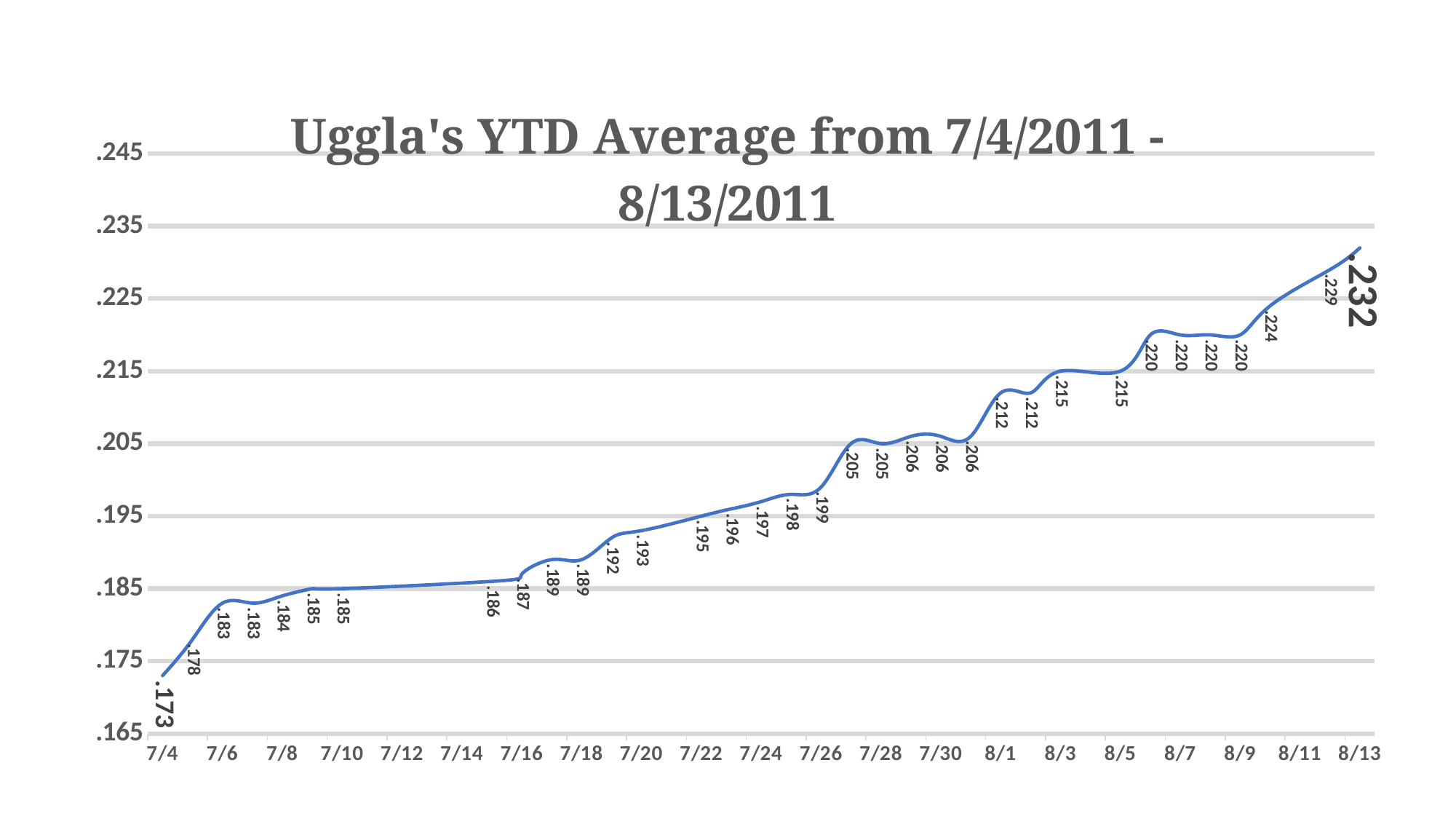
What is the difference between the YTD average on 8/13 and on 7/4? .059 Does the YTD average generally rise or fall from 7/4 to 8/13? Rise What is Uggla's YTD average on 7/4? .173 Is the value for 7/4 greater or less than .175? less What kind of chart is shown on the slide? Line chart Which is larger, the YTD average on 8/1 or on 7/20? 8/1 What is Uggla's YTD average on 7/16? .187 What is the title of the chart? Uggla's YTD Average from 7/4/2011 - 8/13/2011 What is Uggla's YTD average on 8/13? .232 On which date is the YTD average highest? 8/13 On which date is the YTD average lowest? 7/4